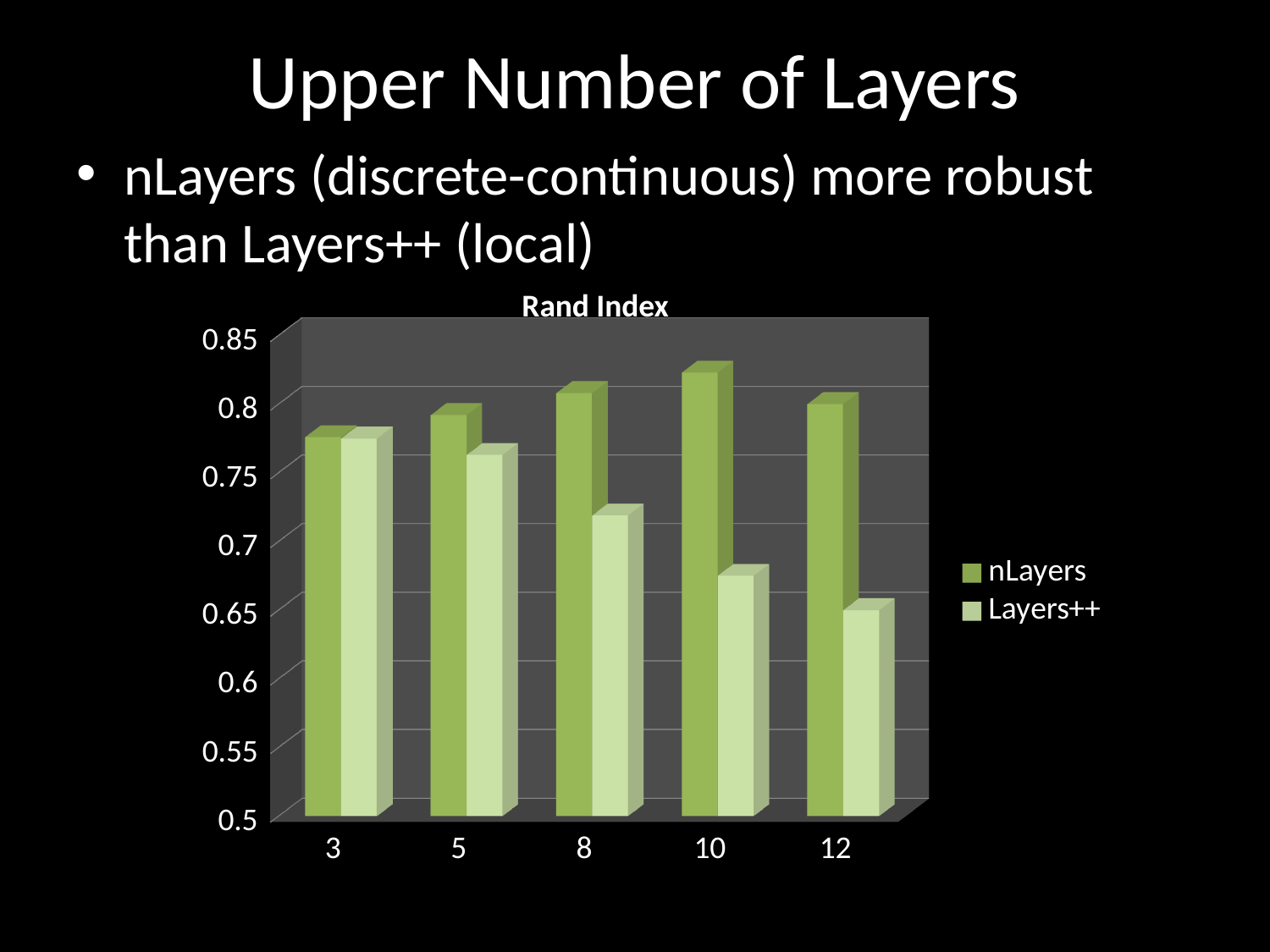
Is the nLayers value for 10 greater or less than 0.8? greater At category 12, which series has the larger value, nLayers or Layers++? nLayers What is the title of the chart? Rand Index Do the Layers++ values rise or fall as the number of layers increases along the x axis? fall Is the Layers++ value for 12 greater or less than 0.7? less For which category is the nLayers value highest? 10 What kind of chart is shown on the slide? bar chart How many series does the legend list? 2 Which series does the legend list first? nLayers How many categories are shown on the x axis? 5 For which category is the Layers++ value lowest? 12 For which category is the Layers++ value highest? 3